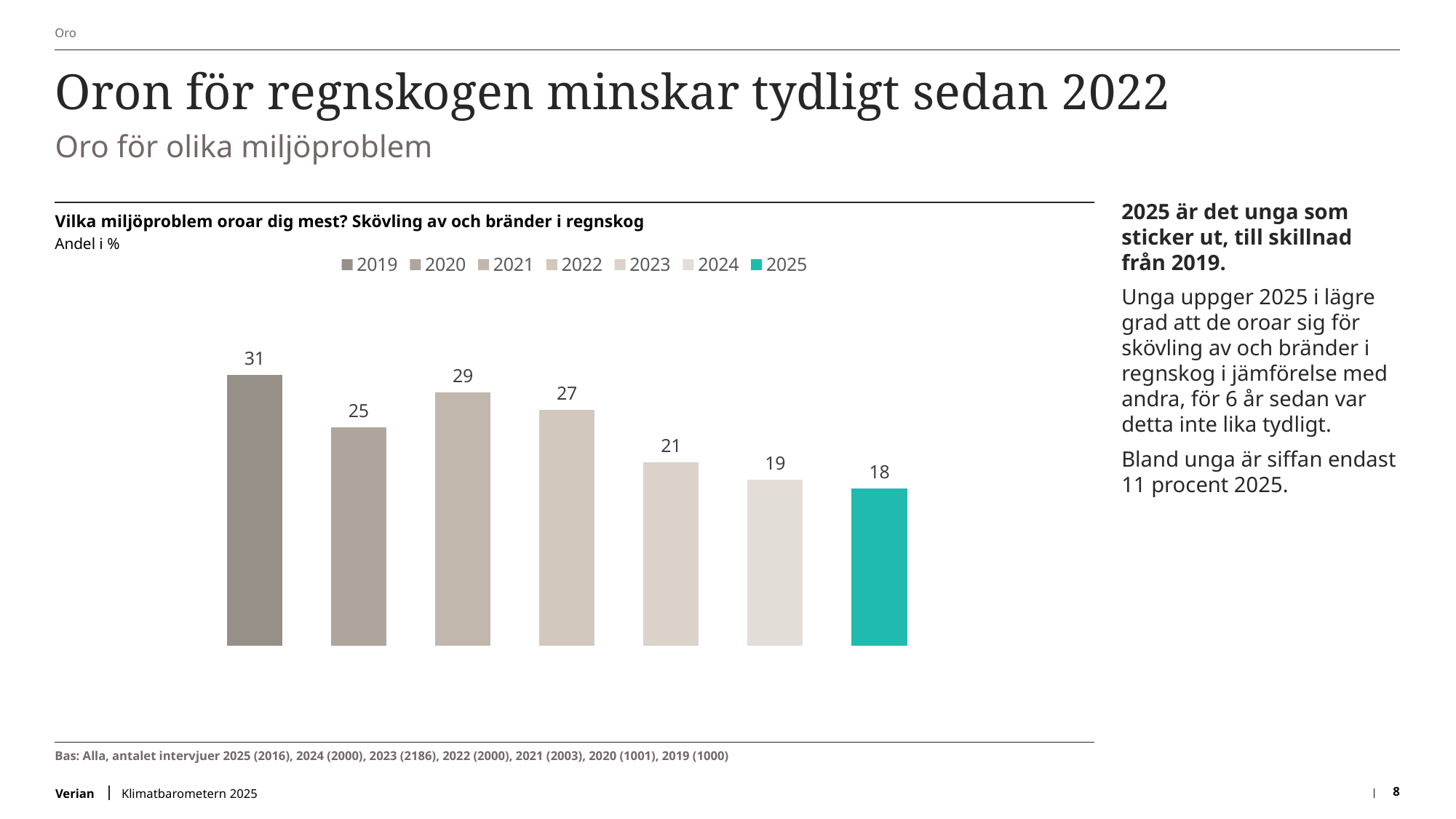
How many entries does the legend list? 7 Which year has the lowest value? 2025 Which year has the highest value? 2019 Which is larger, the value for 2020 or the value for 2021? 2021 What is the difference between the values for 2021 and 2022? 2 What kind of chart is shown on the slide? Bar chart What is the difference between the values for 2019 and 2025? 13 What is the value for 2019? 31 How many bars are shown in the chart? 7 What is the value for 2022? 27 What is the value for 2025? 18 Do the values rise or fall from 2022 to 2025? Fall